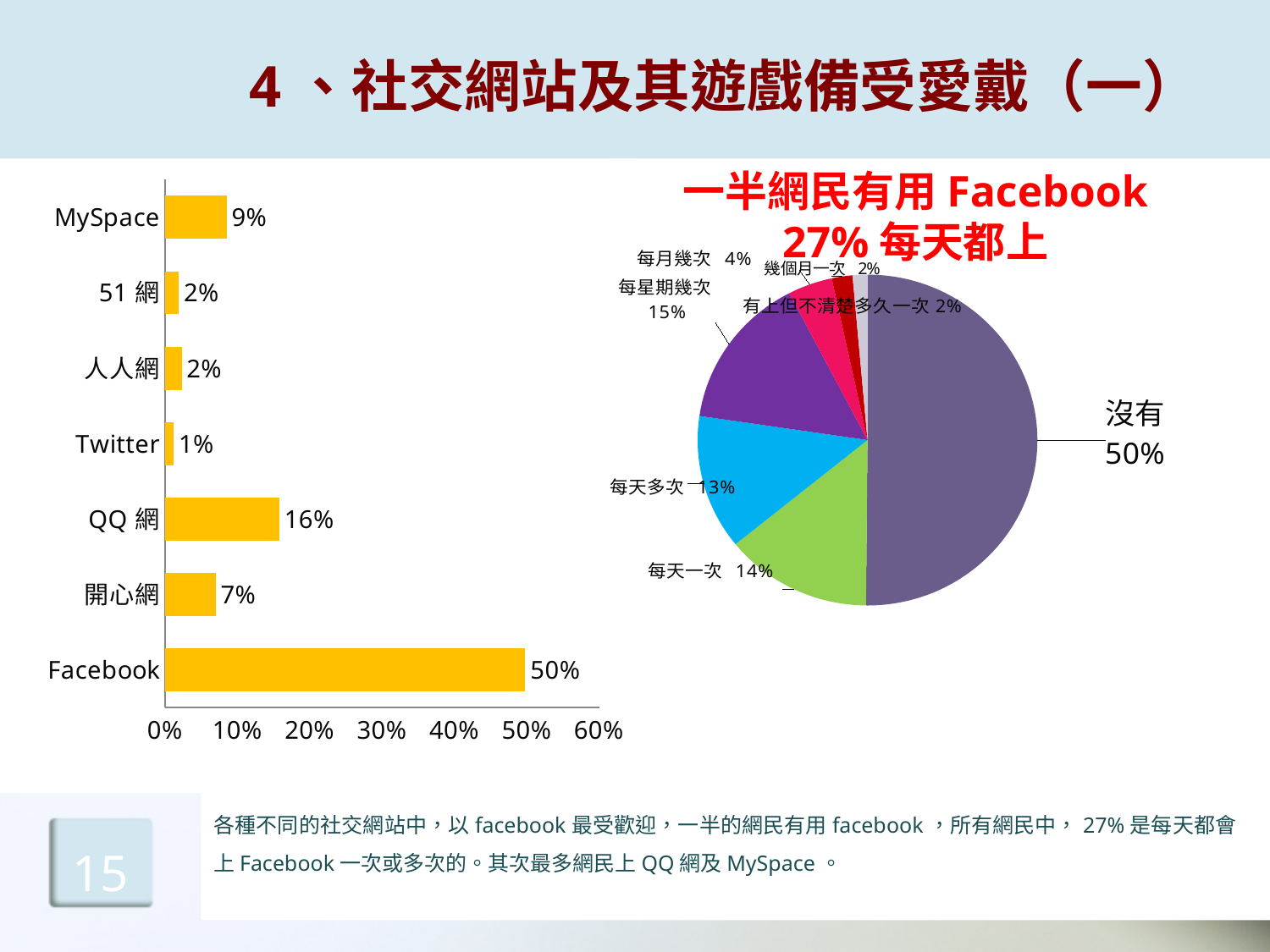
In the bar chart on the left, which is larger, the value for 開心網 or the value for MySpace? MySpace What kind of chart is the chart on the left of the slide? Bar chart In the bar chart on the left, which site has the lowest value? Twitter In the bar chart on the left, what is the value for QQ 網? 16% In the bar chart on the left, what is the value for MySpace? 9% How many sites are shown in the bar chart on the left? 7 In the pie chart on the right, what share does 沒有 have? 50% In the pie chart on the right, which is larger, 每天一次 or 每月幾次? 每天一次 In the bar chart on the left, which site has the highest value? Facebook How many slices does the pie chart on the right have? 7 In the bar chart on the left, what is the difference between the values for Facebook and QQ 網? 34% In the pie chart on the right, what is the value for 每星期幾次? 15%